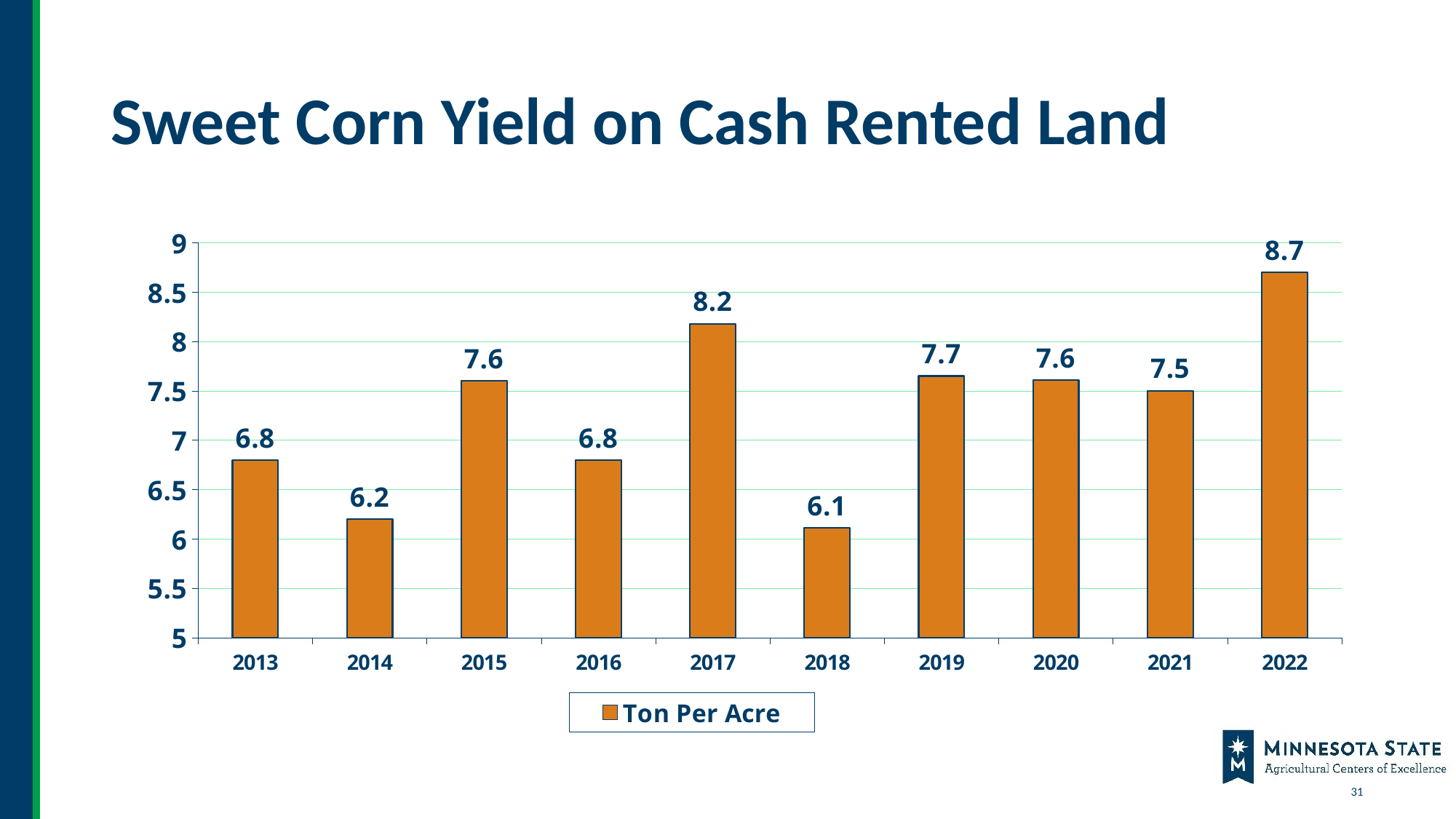
What is the sweet corn yield in tons per acre for 2021? 7.5 What is the sweet corn yield in tons per acre for 2017? 8.2 Which year has the larger yield, 2019 or 2021? 2019 How many years are shown on the chart? 10 Is the yield for 2015 greater or less than 7? greater What is the legend entry for the series shown in the chart? Ton Per Acre What is the difference in yield between 2022 and 2018? 2.6 Which year has the highest sweet corn yield? 2022 Which year has the lowest sweet corn yield? 2018 What kind of chart is shown on the slide? bar chart What is the difference in yield between 2017 and 2016? 1.4 What is the sweet corn yield in tons per acre for 2014? 6.2